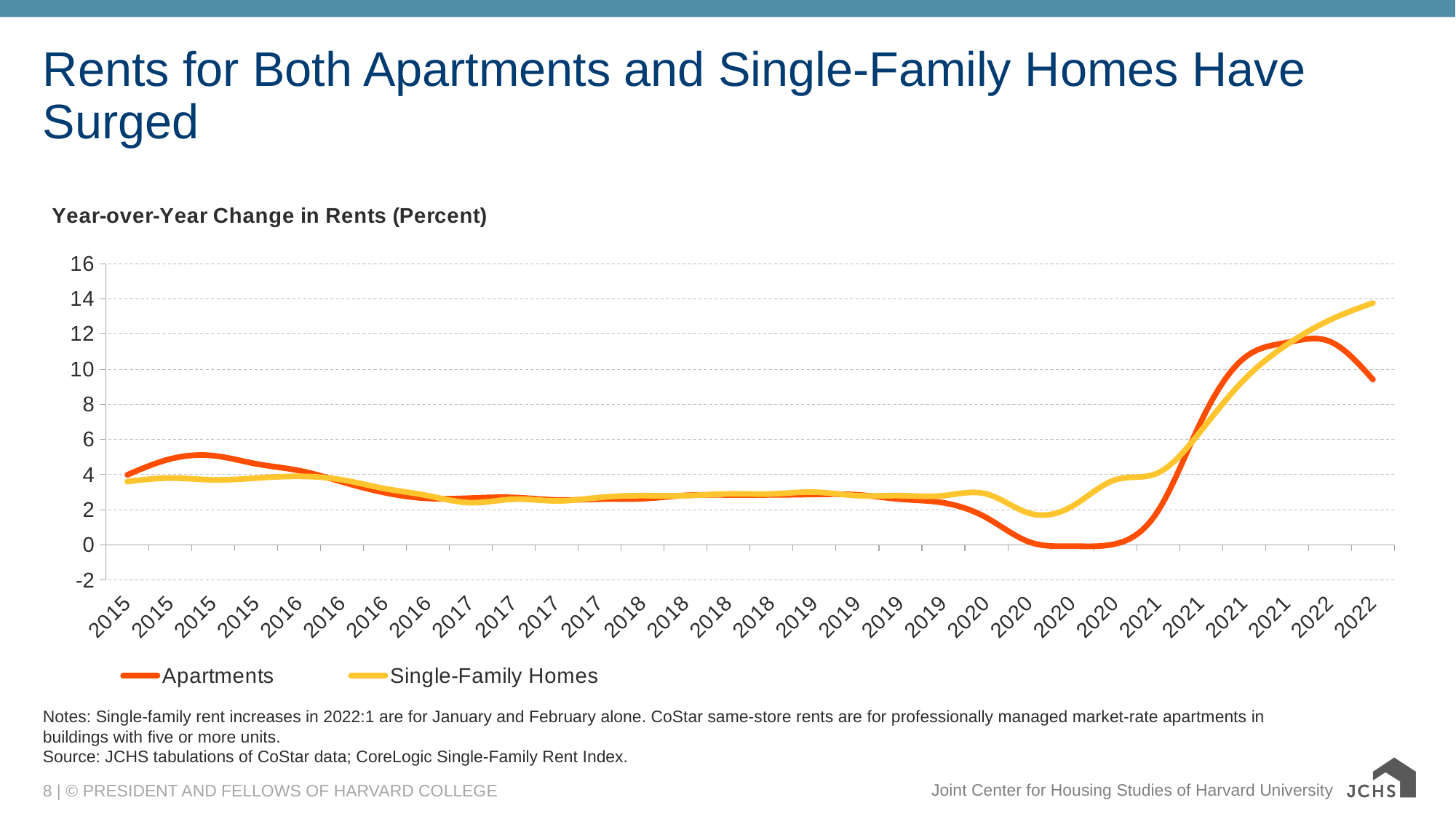
What are the two series named in the legend? Apartments and Single-Family Homes How many labels are shown along the x axis? 30 What is the title printed above the chart? Year-over-Year Change in Rents (Percent) Is the value for Single-Family Homes at the final 2022 point greater or less than 12? greater Do the values for Single-Family Homes rise or fall from 2020 to 2022? rise Is the peak value of the Apartments line greater or less than 10? greater How many series does the legend list? 2 Is the lowest value of the Apartments line, reached in 2020, greater or less than 2? less What is the highest value shown on the y axis? 16 What kind of chart is shown on the slide? line chart At the final 2022 point, which series has the higher value, Apartments or Single-Family Homes? Single-Family Homes